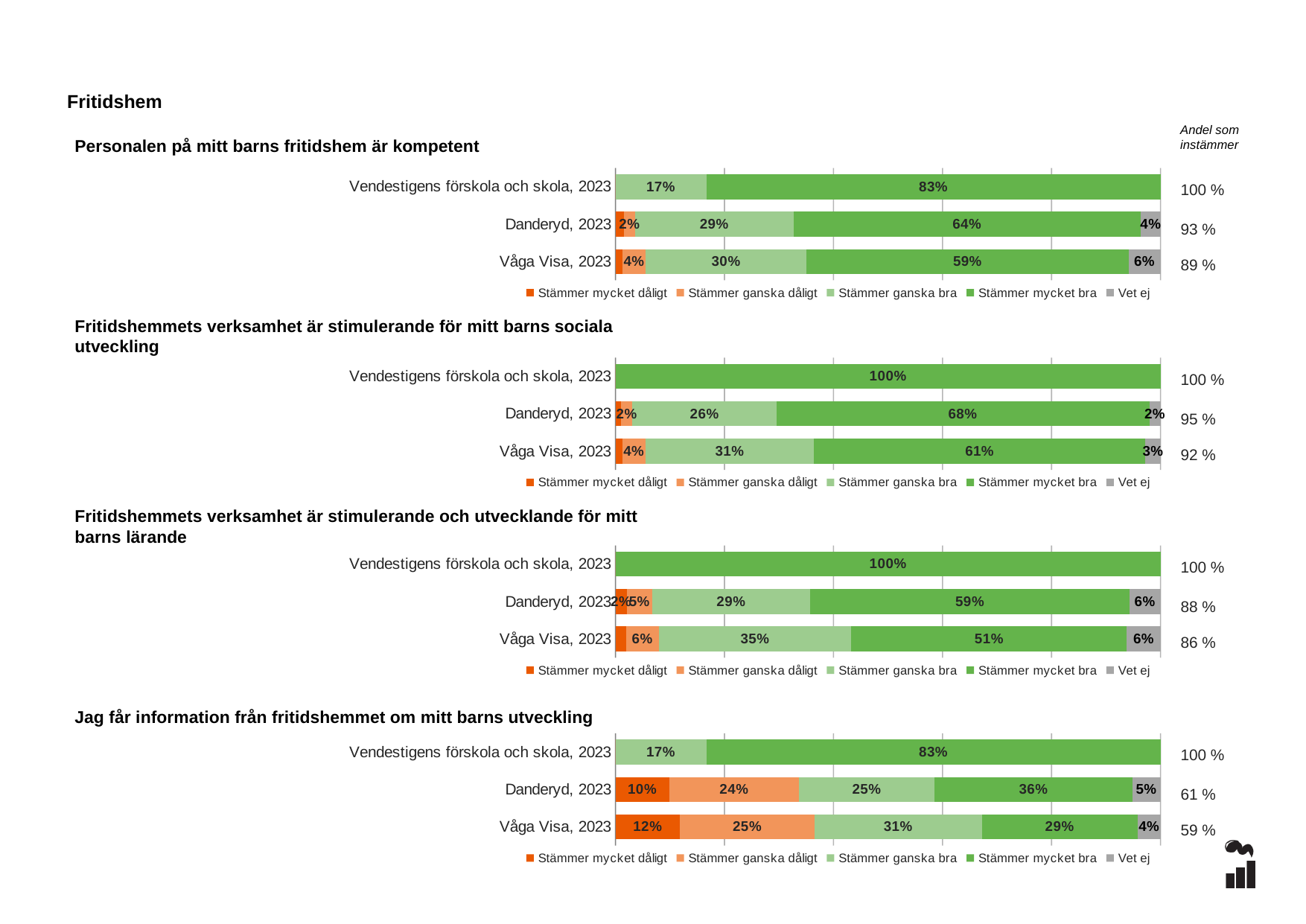
What kind of chart is 'Jag får information från fritidshemmet om mitt barns utveckling'? Stacked bar chart In the chart 'Fritidshemmets verksamhet är stimulerande för mitt barns sociala utveckling', which category has the highest 'Stämmer mycket bra' value? Vendestigens förskola och skola, 2023 In the chart 'Jag får information från fritidshemmet om mitt barns utveckling', what is the 'Stämmer mycket dåligt' value for Våga Visa, 2023? 12% How many series does the legend list in the chart 'Personalen på mitt barns fritidshem är kompetent'? 5 In the chart 'Jag får information från fritidshemmet om mitt barns utveckling', which is larger: the 'Stämmer mycket bra' value for Danderyd, 2023 or for Våga Visa, 2023? Danderyd, 2023 In the chart 'Jag får information från fritidshemmet om mitt barns utveckling', what is the 'Andel som instämmer' for Danderyd, 2023? 61 % In the chart 'Fritidshemmets verksamhet är stimulerande och utvecklande för mitt barns lärande', what is the 'Stämmer ganska bra' value for Våga Visa, 2023? 35% In the chart 'Personalen på mitt barns fritidshem är kompetent', what is the 'Stämmer ganska bra' value for Danderyd, 2023? 29% In the chart 'Fritidshemmets verksamhet är stimulerande för mitt barns sociala utveckling', what is the 'Stämmer mycket bra' value for Danderyd, 2023? 68% In the chart 'Fritidshemmets verksamhet är stimulerande och utvecklande för mitt barns lärande', what is the difference between the 'Stämmer mycket bra' values for Danderyd, 2023 and Våga Visa, 2023? 8% In the chart 'Personalen på mitt barns fritidshem är kompetent', what is the 'Stämmer mycket bra' value for Vendestigens förskola och skola, 2023? 83% In the chart 'Personalen på mitt barns fritidshem är kompetent', what is the 'Andel som instämmer' for Våga Visa, 2023? 89 %